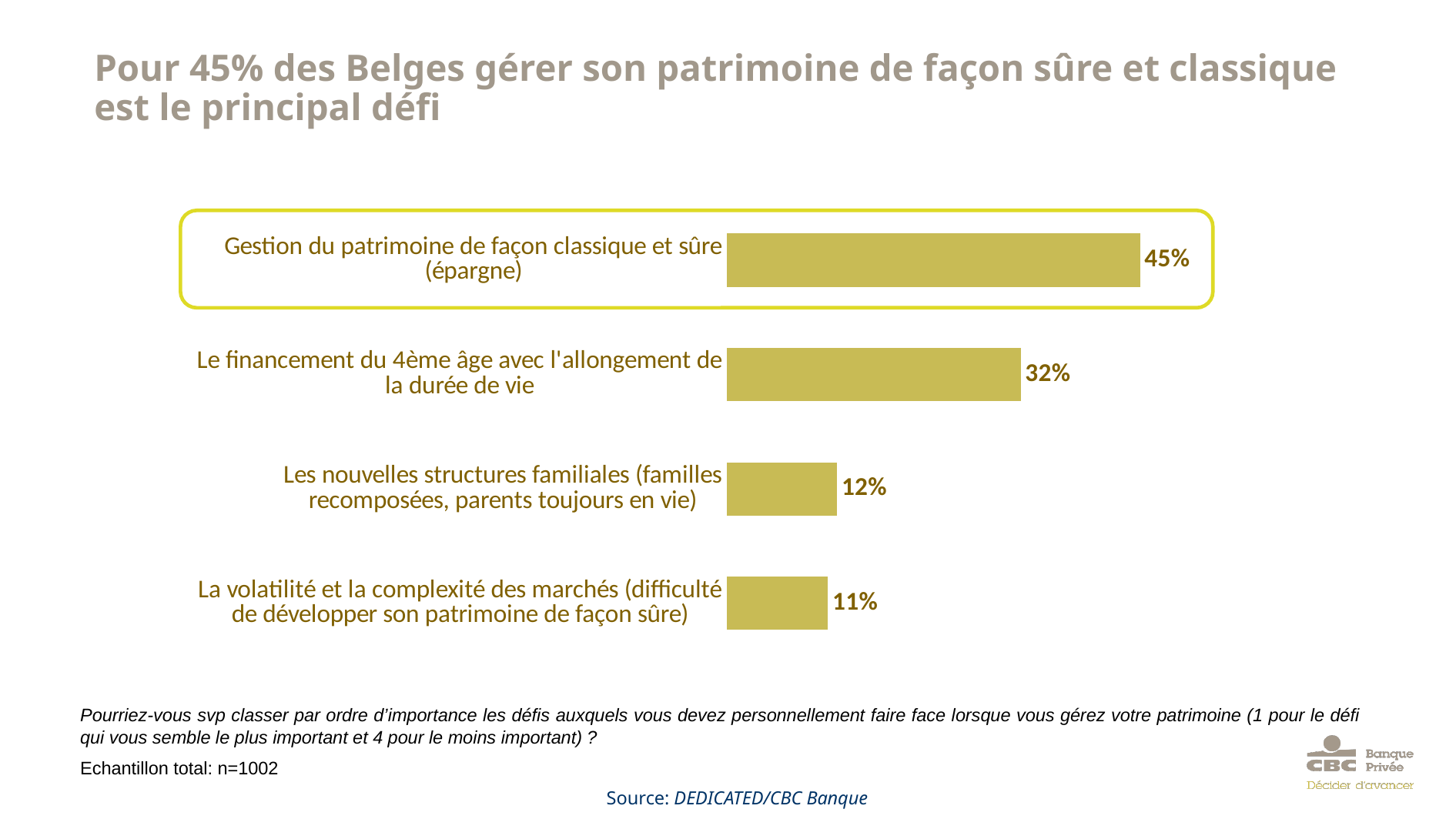
Which category has the highest value? Gestion du patrimoine de façon classique et sûre (épargne) Which category is highlighted with a yellow outline box? Gestion du patrimoine de façon classique et sûre (épargne) What is the difference between the values for "Les nouvelles structures familiales" and "La volatilité et la complexité des marchés"? 1% What is the value for "Gestion du patrimoine de façon classique et sûre (épargne)"? 45% What is the value for "Le financement du 4ème âge avec l'allongement de la durée de vie"? 32% Which category has the lowest value? La volatilité et la complexité des marchés (difficulté de développer son patrimoine de façon sûre) What is the value for "La volatilité et la complexité des marchés (difficulté de développer son patrimoine de façon sûre)"? 11% How many categories are shown in the chart? 4 What is the difference between the values for "Gestion du patrimoine de façon classique et sûre (épargne)" and "Le financement du 4ème âge avec l'allongement de la durée de vie"? 13% What kind of chart is shown on the slide? Bar chart What is the value for "Les nouvelles structures familiales (familles recomposées, parents toujours en vie)"? 12% Which is larger: the value for "Le financement du 4ème âge" or the value for "Les nouvelles structures familiales"? Le financement du 4ème âge